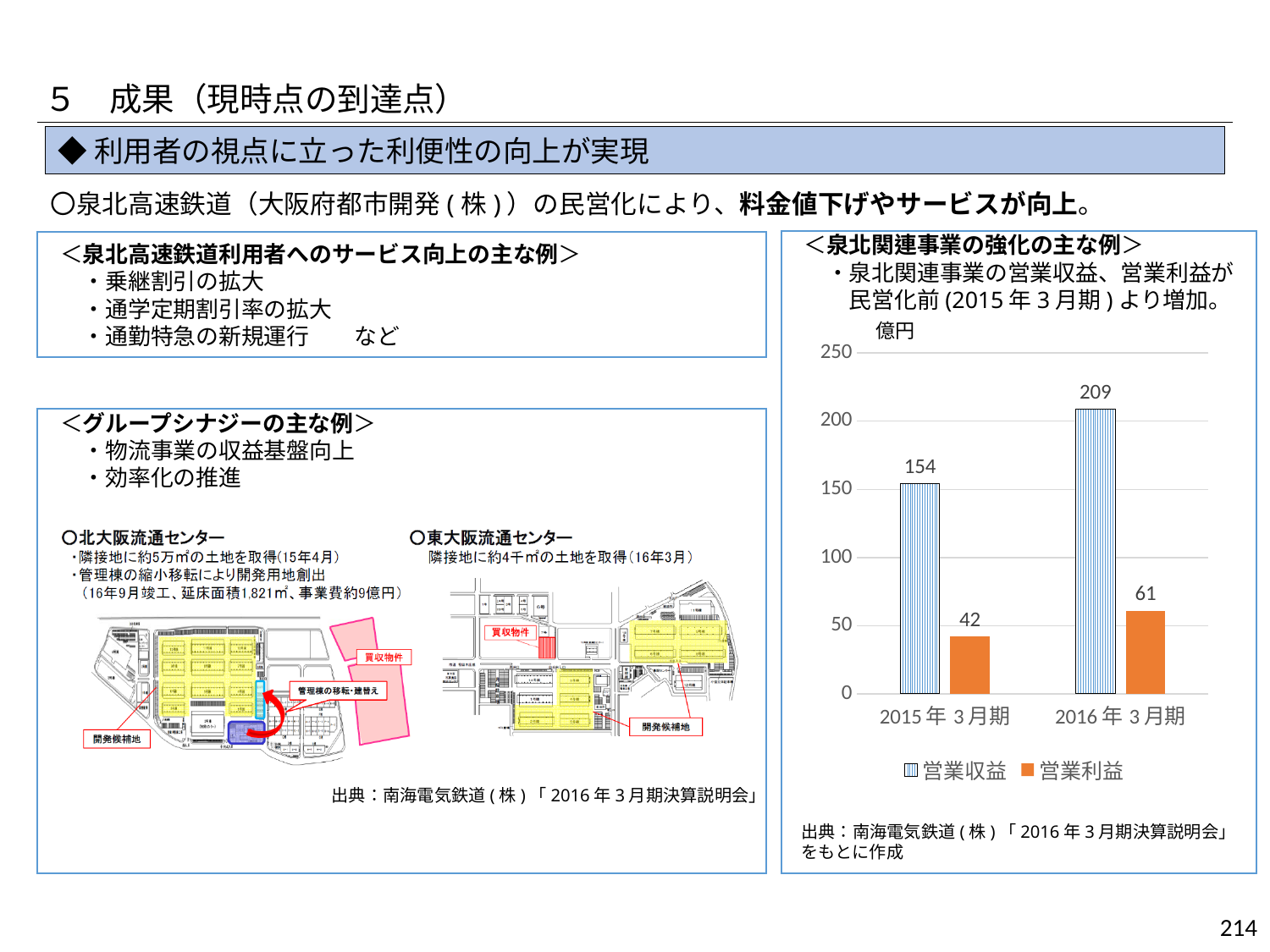
What is the 営業利益 value for 2016年3月期? 61 How many series does the legend list? 2 Which is larger: 営業利益 in 2015年3月期 or 営業利益 in 2016年3月期? 営業利益 in 2016年3月期 What is the 営業収益 value for 2016年3月期? 209 What kind of chart is shown on the slide? bar chart What unit is shown above the vertical axis of the chart? 億円 How many periods are shown on the x axis? 2 Which period has the higher 営業収益? 2016年3月期 By how much did 営業収益 increase from 2015年3月期 to 2016年3月期? 55 What is the 営業利益 value for 2015年3月期? 42 By how much did 営業利益 increase from 2015年3月期 to 2016年3月期? 19 What is the 営業収益 value for 2015年3月期? 154